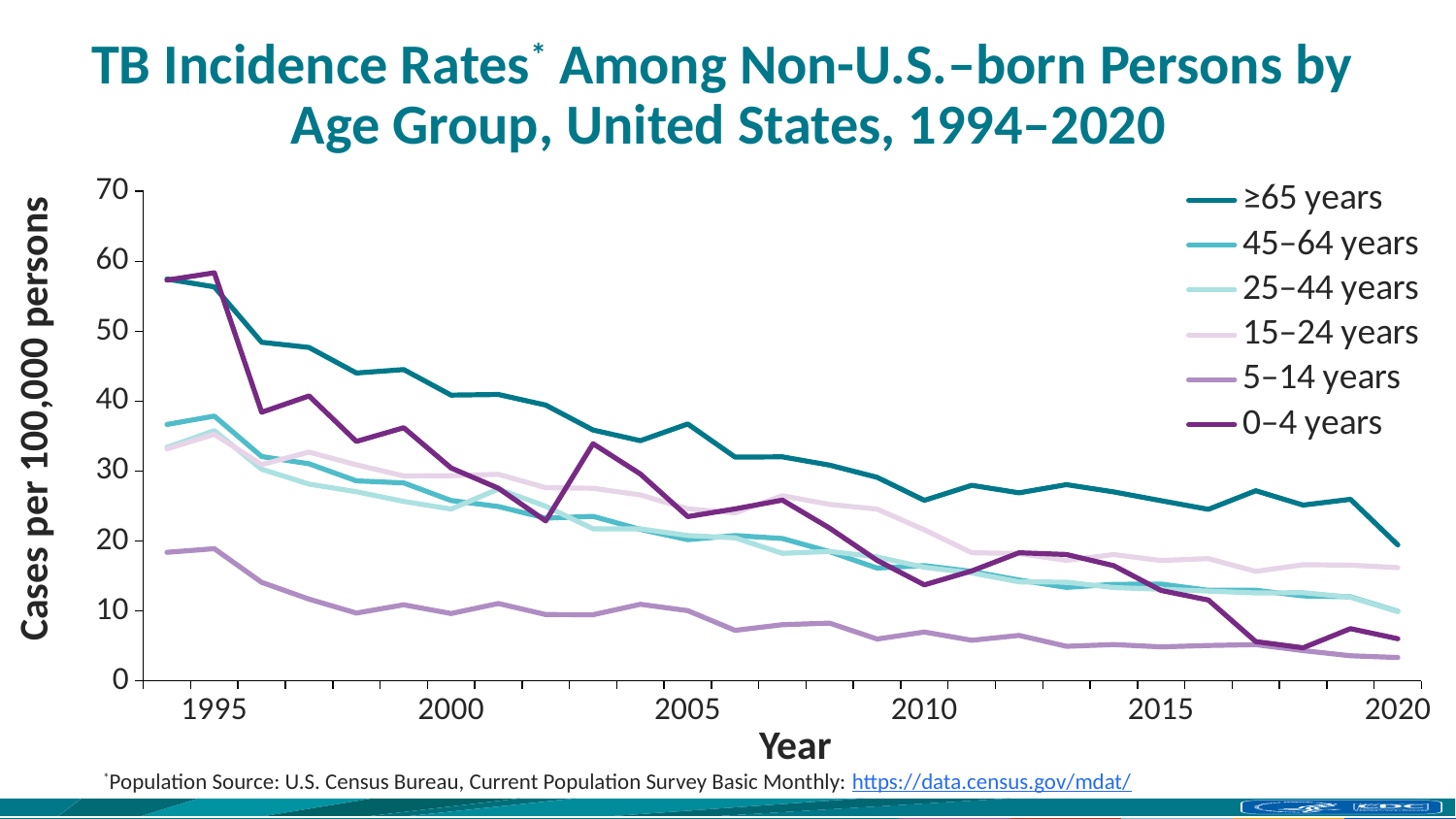
Which age group has the highest TB incidence rate in 2010? ≥65 years How many series does the legend list? 6 Does the TB incidence rate for ≥65 years rise or fall from 1994 to 2020? fall Which age group has the lowest TB incidence rate in 2020? 5–14 years Is the value for 5–14 years in 2020 greater or less than 10? less Is the value for ≥65 years in 2020 greater or less than 30? less Is the value for ≥65 years in 1995 greater or less than 50? greater What is the label on the y axis? Cases per 100,000 persons Which age group has the lowest TB incidence rate in 1995? 5–14 years In 2010, which is larger: the value for ≥65 years or the value for 0–4 years? ≥65 years What kind of chart is shown on the slide? line chart